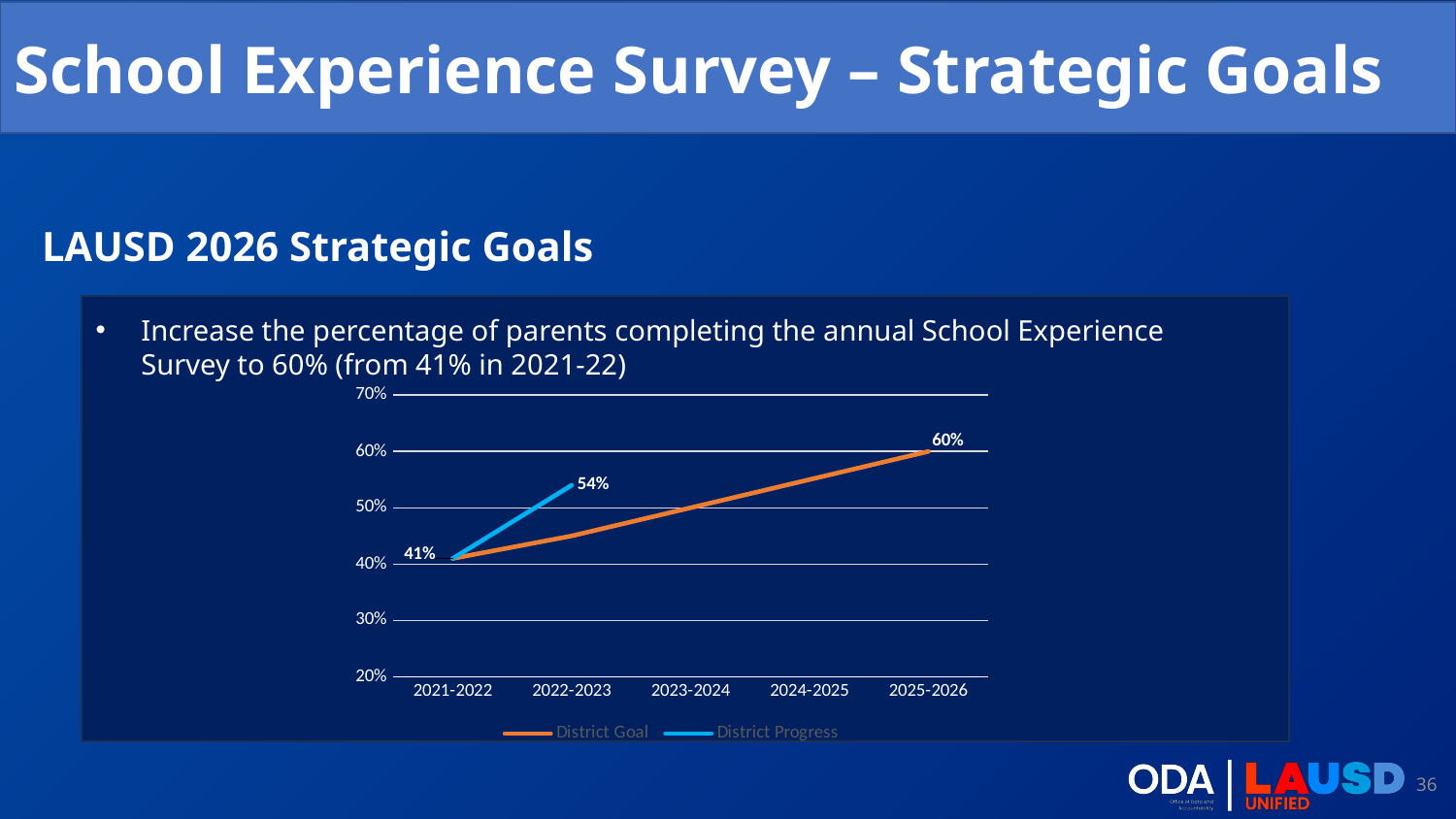
What is the District Goal value for 2025-2026? 60% What is the difference between the District Progress value for 2022-2023 and the value for 2021-2022? 13% What is the difference between the District Goal value for 2025-2026 and the value for 2021-2022? 19% What is the District Progress value for 2022-2023? 54% Does the District Goal line rise or fall from 2021-2022 to 2025-2026? rise How many series does the chart legend list? 2 What are the two series named in the chart legend? District Goal and District Progress What is the value shown for 2021-2022 on the chart? 41% Which is larger: the District Progress value for 2022-2023 or the District Goal value for 2022-2023? District Progress What kind of chart is shown on the slide? line chart How many school years are shown on the x axis of the chart? 5